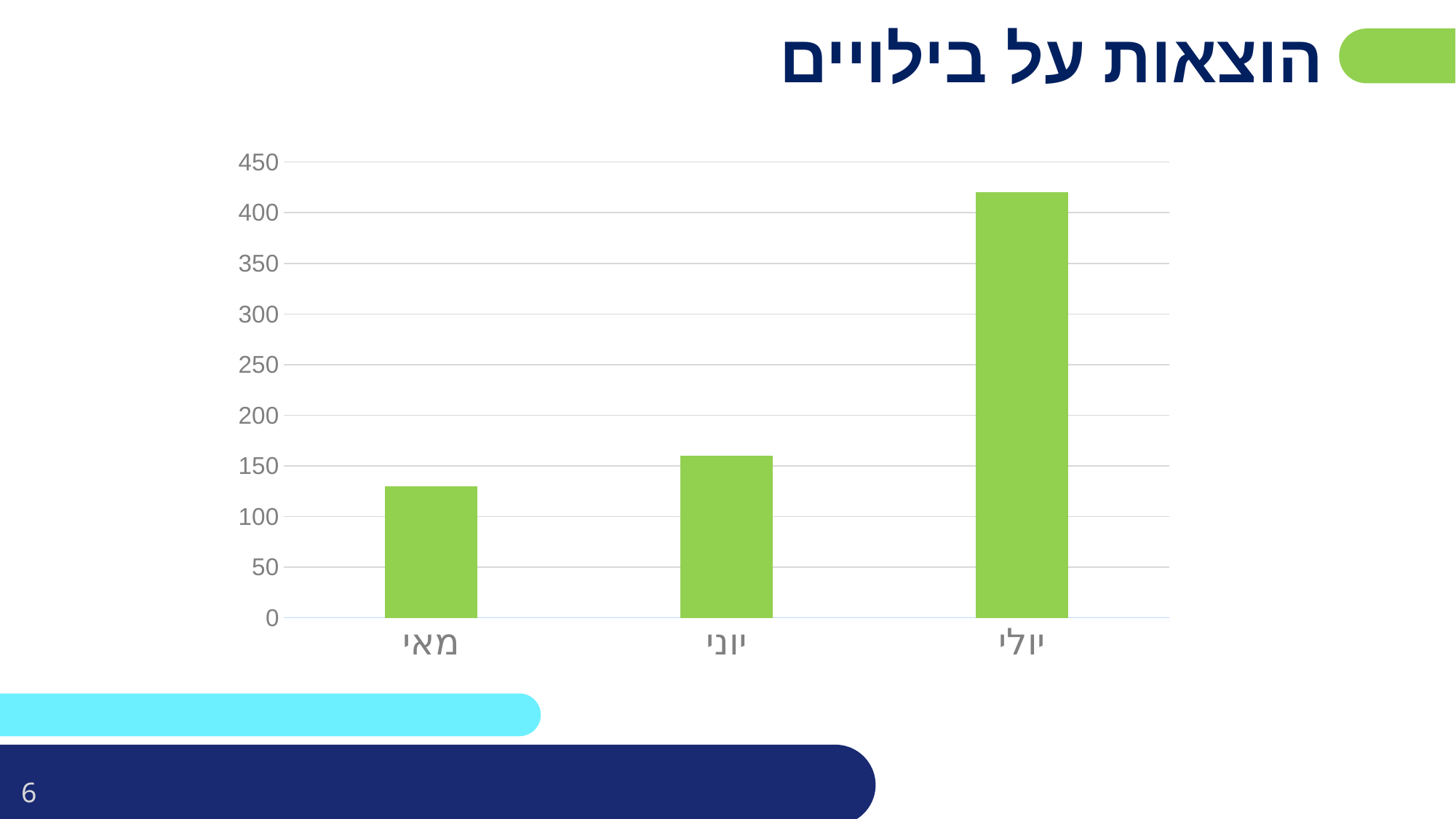
What colour are the bars in the chart? green Is the value for יוני greater or less than 150? greater How many categories are shown on the x axis of the chart? 3 Is the value for יוני greater or less than 200? less Which category has the highest value in the chart? יולי What is the title of the chart? הוצאות על בילויים Which category has the lowest value in the chart? מאי Which is larger, the value for יוני or the value for מאי? יוני Is the value for מאי greater or less than 150? less Do the values rise or fall from מאי to יולי along the x axis? rise What kind of chart is shown on the slide? bar chart